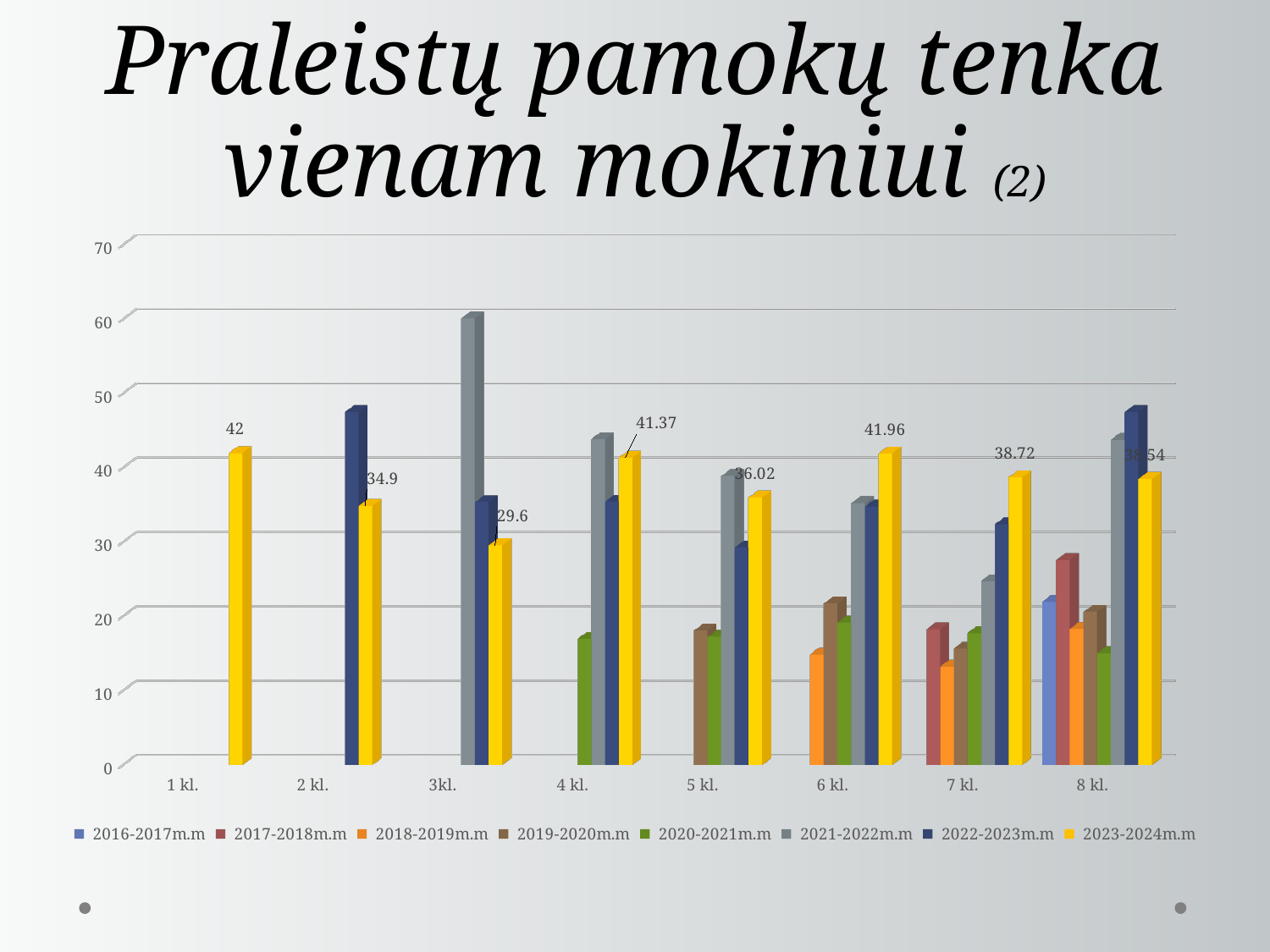
How many class categories are shown on the x axis? 8 What is the difference between the 2023-2024m.m values for 1 kl. and 3kl.? 12.4 How many series does the legend list? 8 Which class has the lowest value in the 2023-2024m.m series? 3kl. What is the value for 3kl. in the 2023-2024m.m series? 29.6 What is the value for 6 kl. in the 2023-2024m.m series? 41.96 What kind of chart is shown on the slide? bar chart What is the title of the slide containing the chart? Praleistų pamokų tenka vienam mokiniui (2) What is the value for 4 kl. in the 2023-2024m.m series? 41.37 Is the value for 3kl. in the 2021-2022m.m series greater or less than 50? greater For 2 kl., which is larger: the 2022-2023m.m value or the 2023-2024m.m value? 2022-2023m.m What is the value for 1 kl. in the 2023-2024m.m series? 42